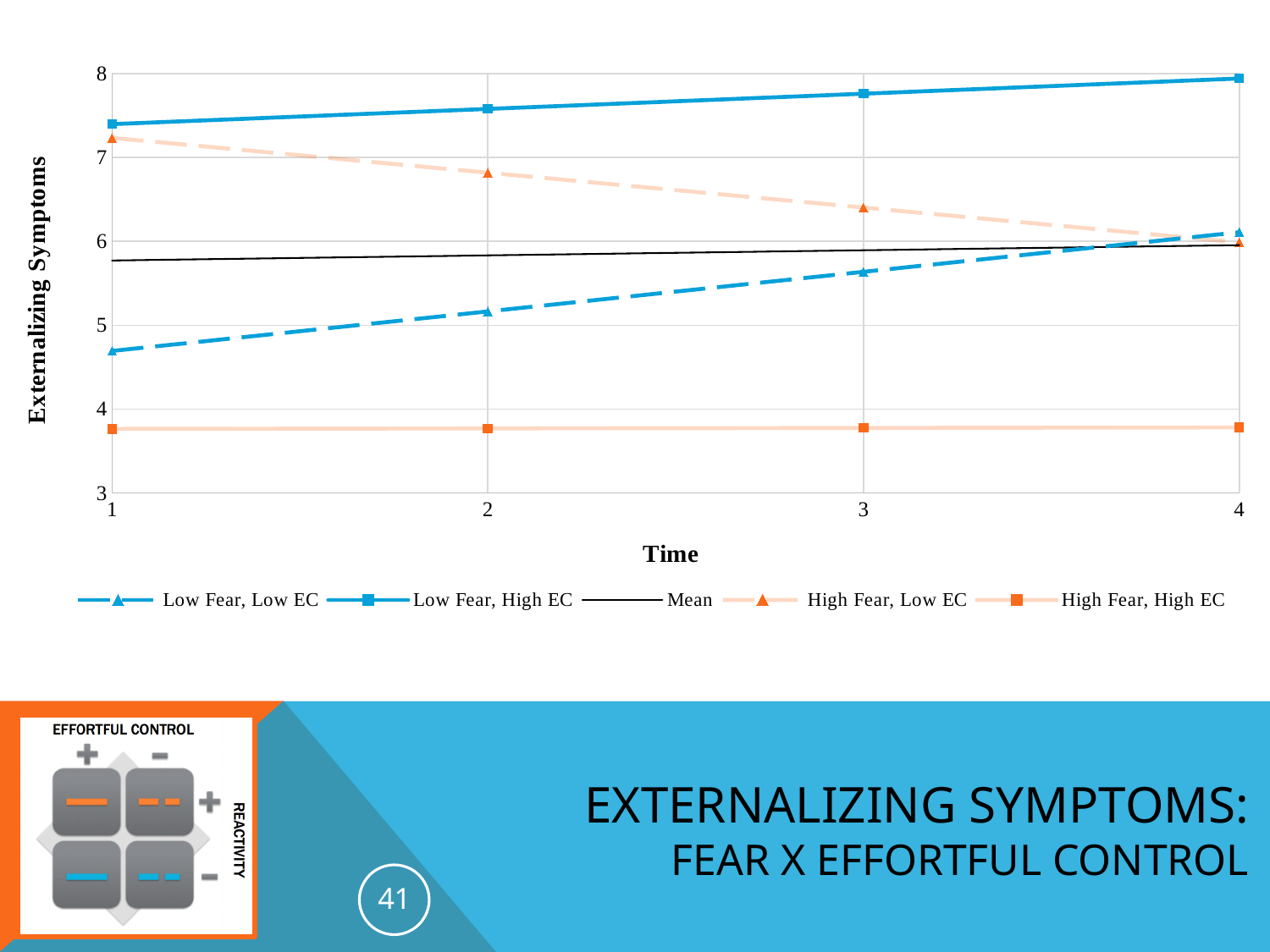
What kind of chart is shown on the slide? Line chart Is the value for High Fear, High EC at Time 4 greater or less than 4? less Which series has the lowest value at Time 1? High Fear, High EC How many time points are plotted along the x axis? 4 Does the High Fear, Low EC line rise or fall from Time 1 to Time 4? Fall Does the Low Fear, Low EC line rise or fall from Time 1 to Time 4? Rise Is the value for Low Fear, High EC at Time 1 greater or less than 7? greater At Time 2, which is larger: High Fear, Low EC or Low Fear, Low EC? High Fear, Low EC Which series has the highest value at Time 4? Low Fear, High EC How many series does the legend list? 5 What is the title of the y axis? Externalizing Symptoms Is the value for Low Fear, Low EC at Time 1 greater or less than 5? less